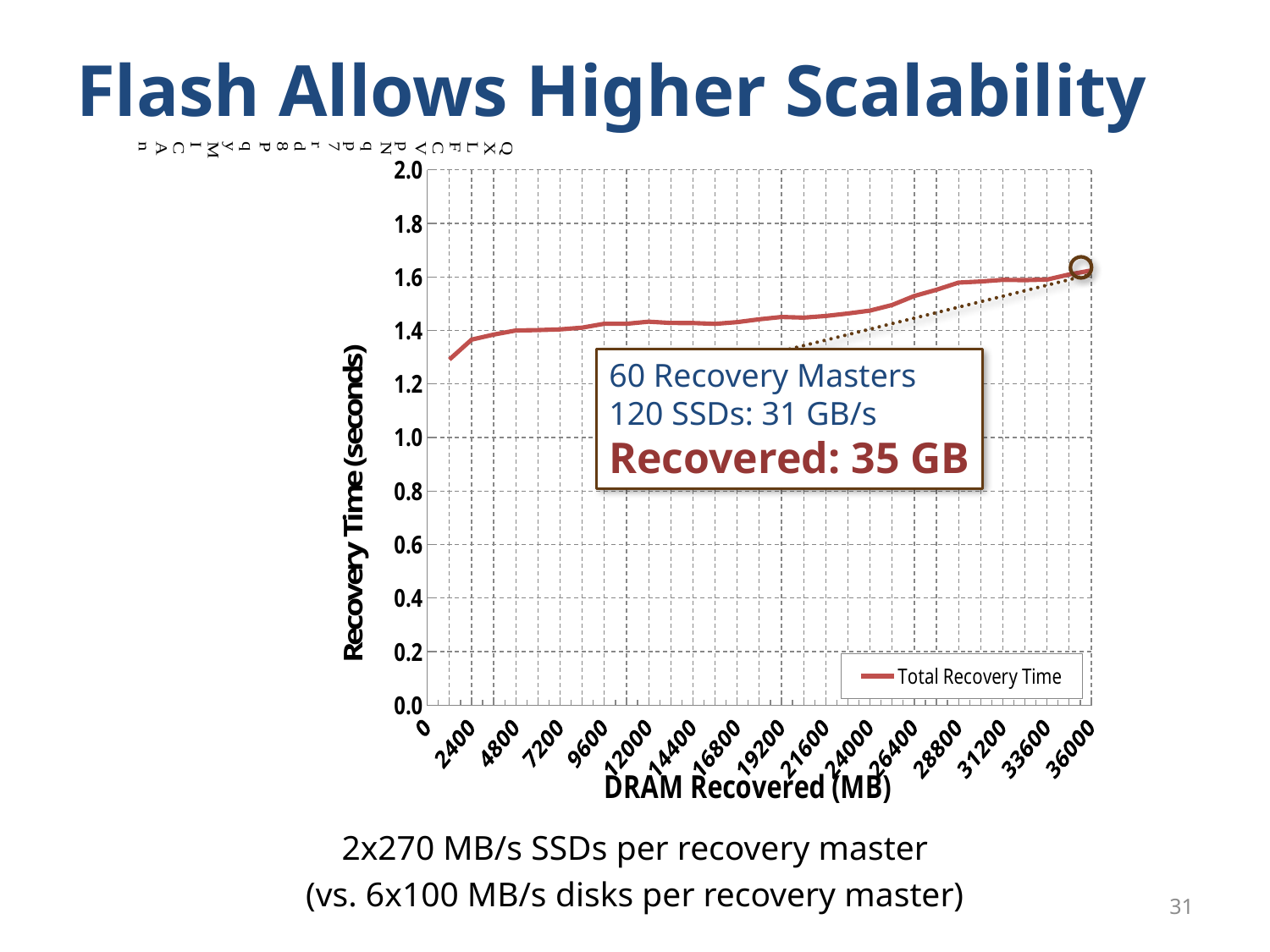
Is the Total Recovery Time at 28800 MB greater or less than 1.4 seconds? greater Is the Total Recovery Time at 2400 MB greater or less than 1.2 seconds? greater Is the Total Recovery Time at 36000 MB greater or less than 1.8 seconds? less What kind of chart is shown on the slide? line chart At which DRAM Recovered value on the x axis is the Total Recovery Time highest? 36000 What is the title of the chart's y axis? Recovery Time (seconds) What is the name of the series shown in the chart's legend? Total Recovery Time How many series does the chart's legend list? 1 Which is larger, the Total Recovery Time at 4800 MB or at 31200 MB? 31200 MB Does the Total Recovery Time rise or fall as DRAM Recovered increases along the x axis? rise Is the Total Recovery Time lowest at the left end or the right end of the x axis? left end